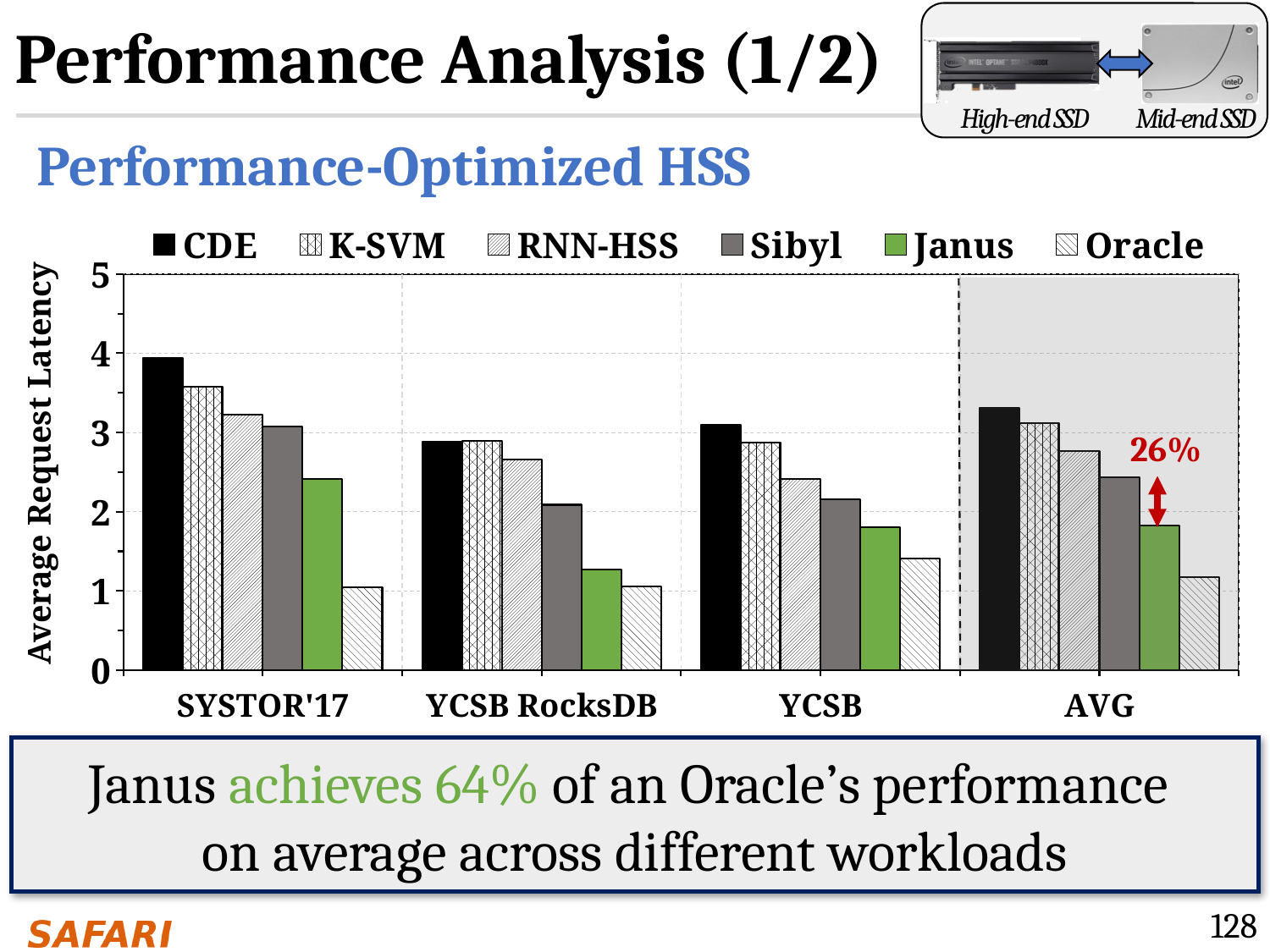
Is the value for Janus on YCSB RocksDB greater or less than 2? less What is the label of the y axis? Average Request Latency What percentage is annotated between the Janus and Oracle bars in the AVG group? 26% Which series has the highest average request latency for SYSTOR'17? CDE What kind of chart is shown on the slide? Bar chart For AVG, which has the larger average request latency, Sibyl or Janus? Sibyl Which series has the lowest average request latency for YCSB? Oracle How many series does the legend list? 6 Which is larger, the CDE value for SYSTOR'17 or the CDE value for YCSB? SYSTOR'17 Is the value for CDE on SYSTOR'17 greater or less than 3? greater How many workload categories are shown on the x axis? 4 Is the value for Oracle on YCSB greater or less than 1? greater